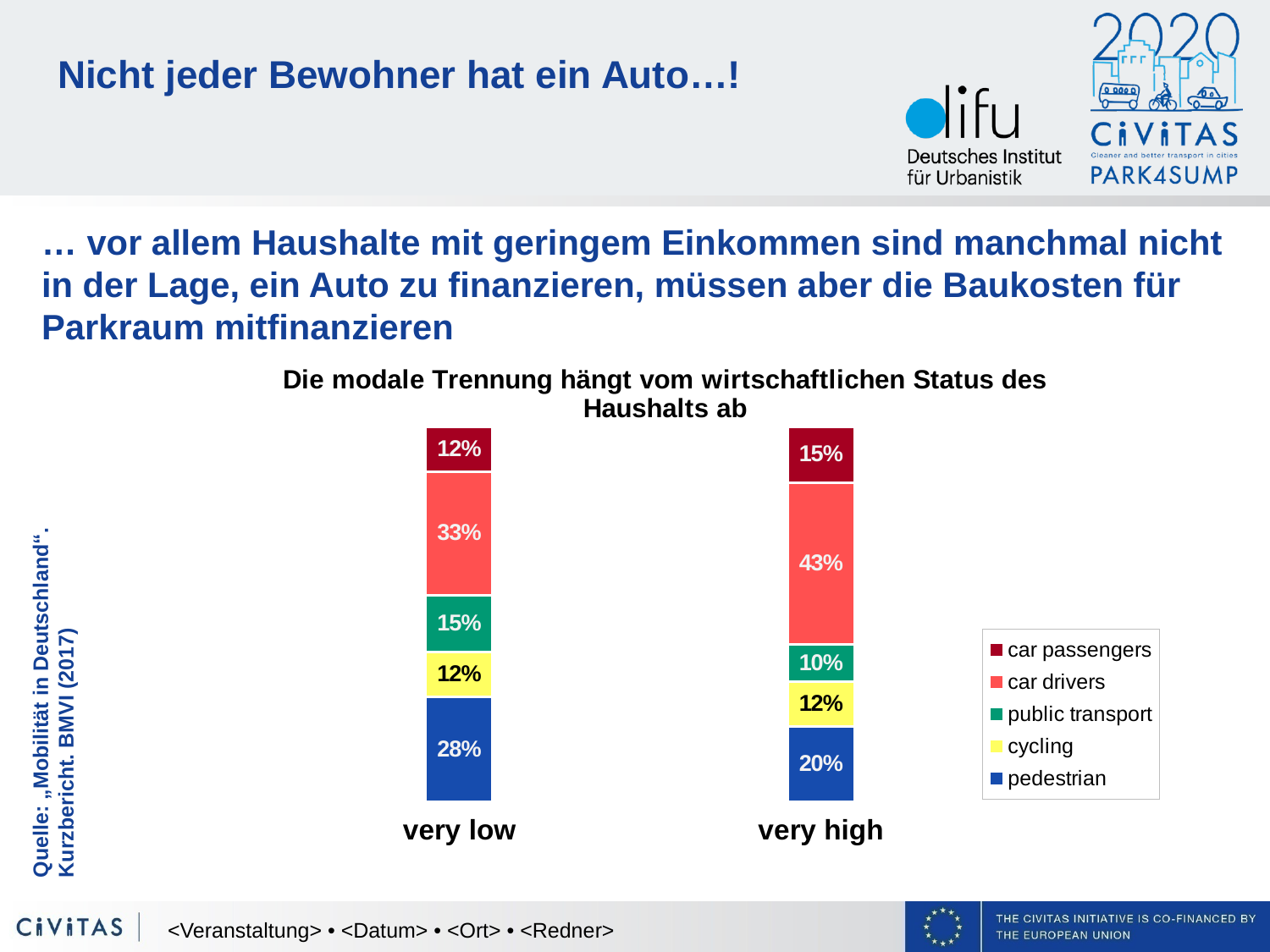
How many series does the legend list? 5 What is the total of the stacked bar for the 'very low' group? 100% What share of trips is made by car drivers in the 'very high' household group? 43% Which mode has the largest share in the 'very high' group? car drivers What is the car passengers share for the 'very high' group? 15% Which group has the larger pedestrian share, 'very low' or 'very high'? very low What share of trips is made by car drivers in the 'very low' household group? 33% What kind of chart is shown on the slide? stacked bar chart What is the public transport share for the 'very low' group? 15% What is the pedestrian share for the 'very high' group? 20% Which mode has the smallest share in the 'very high' group? public transport How much higher is the car drivers share in the 'very high' group than in the 'very low' group? 10 percentage points